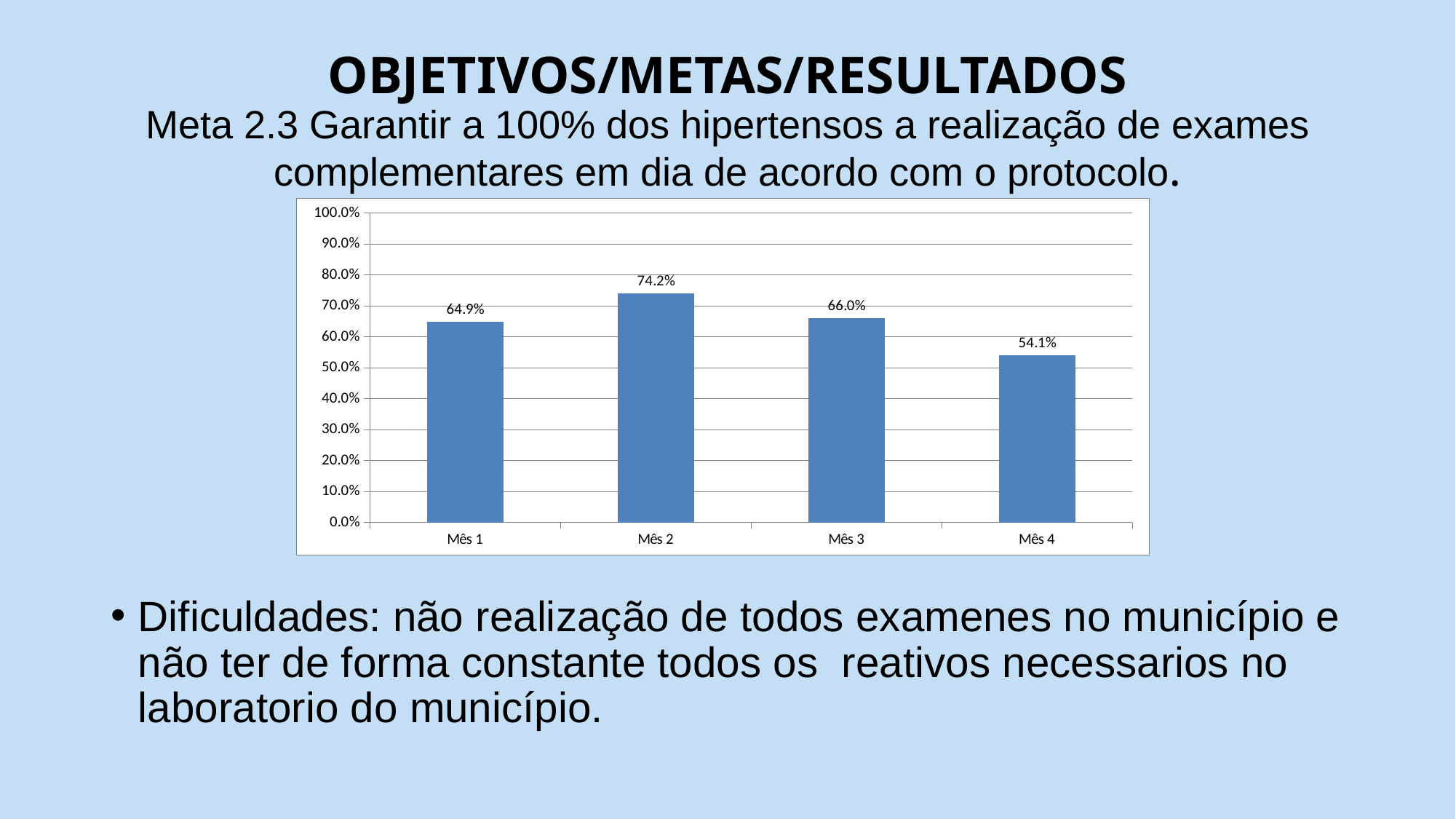
What is the difference between the values for Mês 2 and Mês 4? 20.1% Which month has the lowest value? Mês 4 What is the value for Mês 4? 54.1% Which month has the highest value? Mês 2 Which is larger, the value for Mês 1 or the value for Mês 3? Mês 3 Is the value for Mês 2 greater or less than 70.0%? greater What is the highest value shown on the y axis? 100.0% What is the value for Mês 1? 64.9% How many months are shown on the x axis? 4 What kind of chart is shown on the slide? bar chart Does the value rise or fall from Mês 3 to Mês 4? fall What is the value for Mês 2? 74.2%